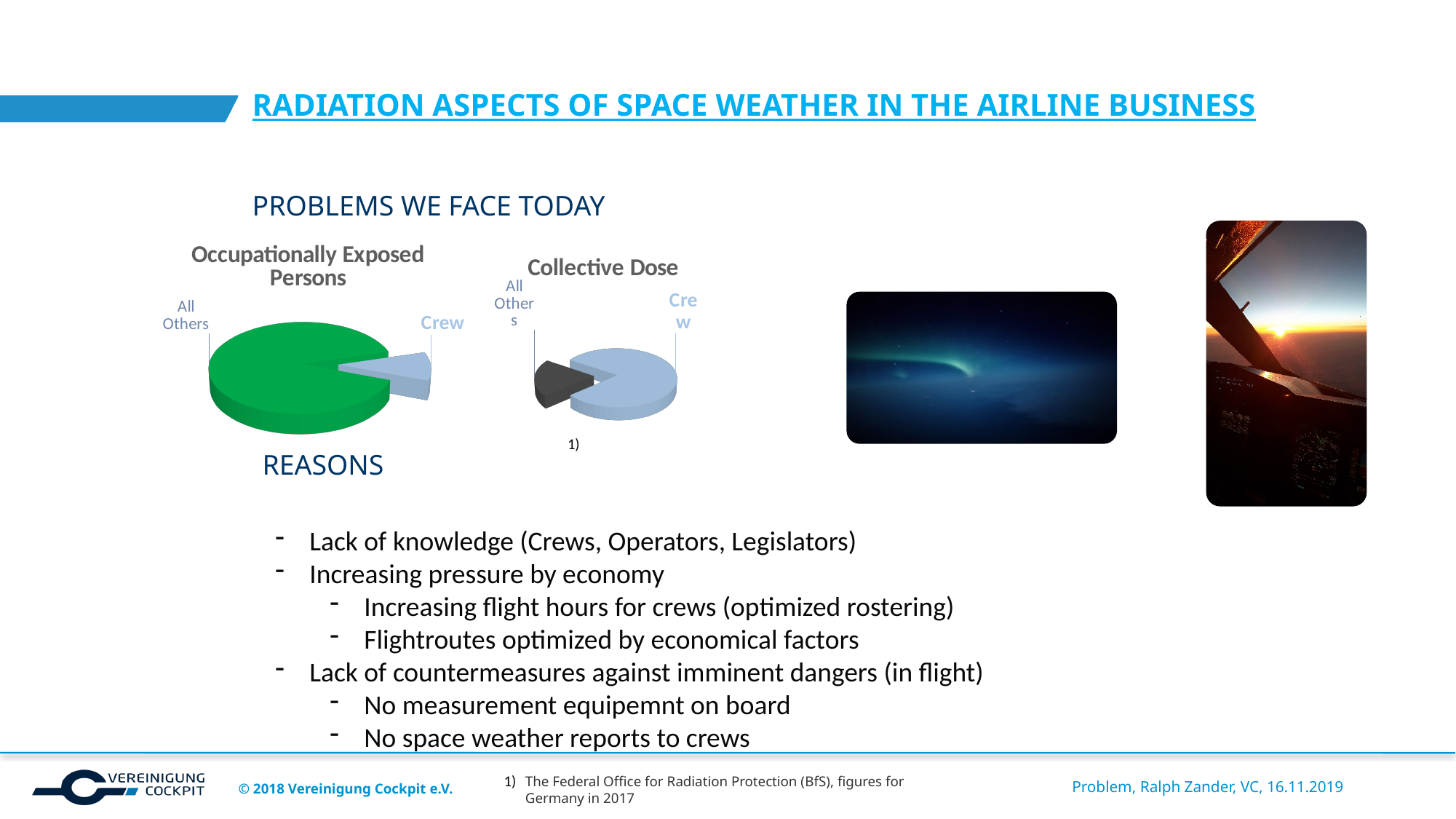
How many slices does the "Occupationally Exposed Persons" pie chart have? 2 What is the title of the pie chart on the right of the two pie charts? Collective Dose In the "Occupationally Exposed Persons" chart, which category has the largest slice? All Others What type of chart is the "Collective Dose" chart? Pie chart In the "Occupationally Exposed Persons" chart, is the Crew slice larger or smaller than the All Others slice? Smaller What type of chart is the "Occupationally Exposed Persons" chart? Pie chart In the "Collective Dose" chart, is the Crew slice larger or smaller than the All Others slice? Larger What colour is the All Others slice in the "Occupationally Exposed Persons" chart? Green In the "Occupationally Exposed Persons" chart, which category has the smallest slice? Crew How many slices does the "Collective Dose" pie chart have? 2 In the "Collective Dose" chart, which category has the smallest slice? All Others In the "Collective Dose" chart, which category has the largest slice? Crew